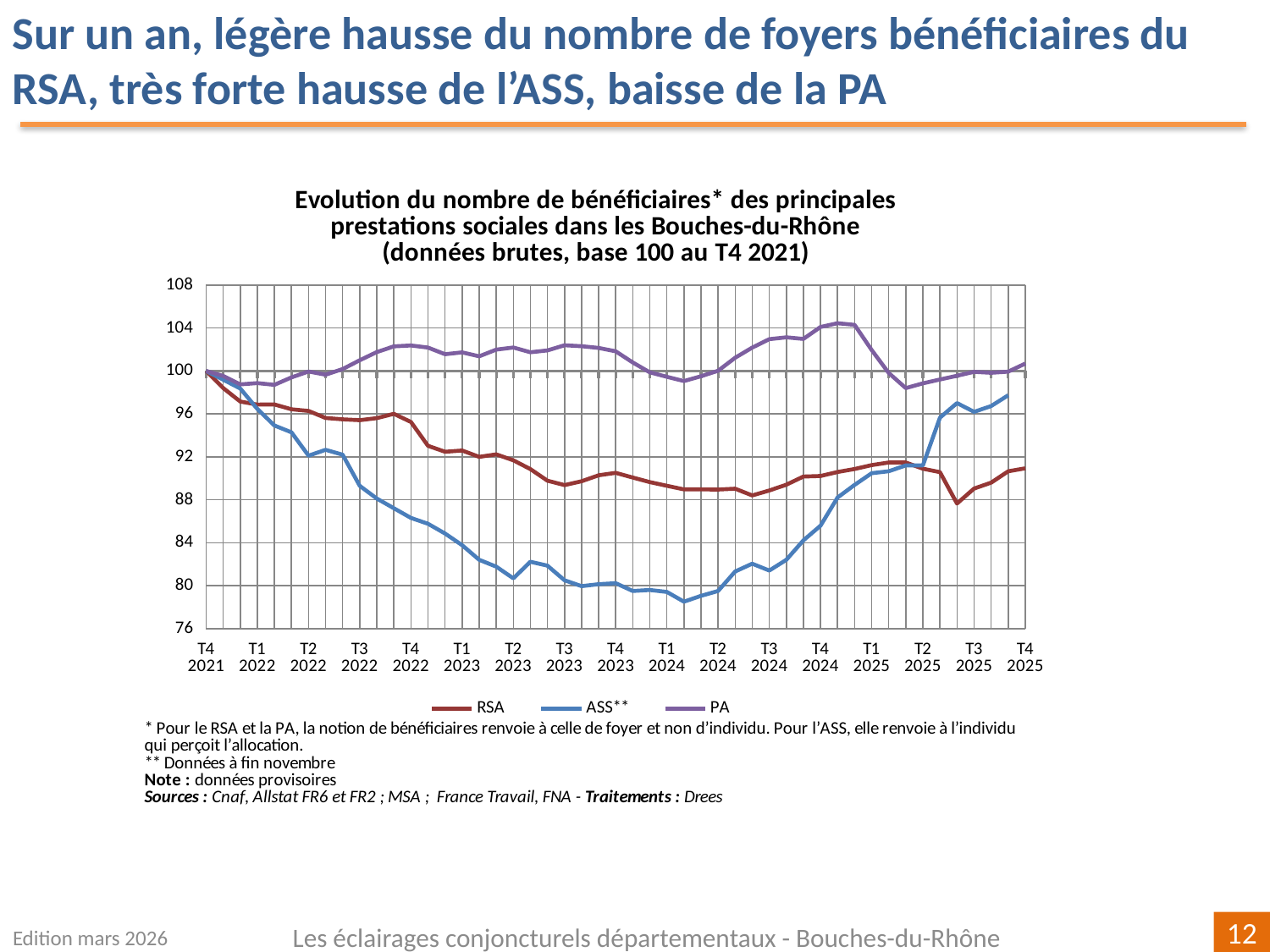
How many series does the legend list? 3 Does the ASS** series rise or fall between T4 2021 and T1 2024? fall What is the value of the RSA series at T4 2021? 100 Is the value of the RSA series at T3 2025 greater or less than 92? less Is the value of the ASS** series at T1 2024 greater or less than 80? less How many quarters are labelled on the x axis? 17 Is the value of the PA series at T4 2024 greater or less than 100? greater What kind of chart is shown on the slide? line chart Which series has the highest value at T4 2024? PA Which series has the lowest value at T1 2024? ASS** Which series are listed in the legend? RSA, ASS**, PA